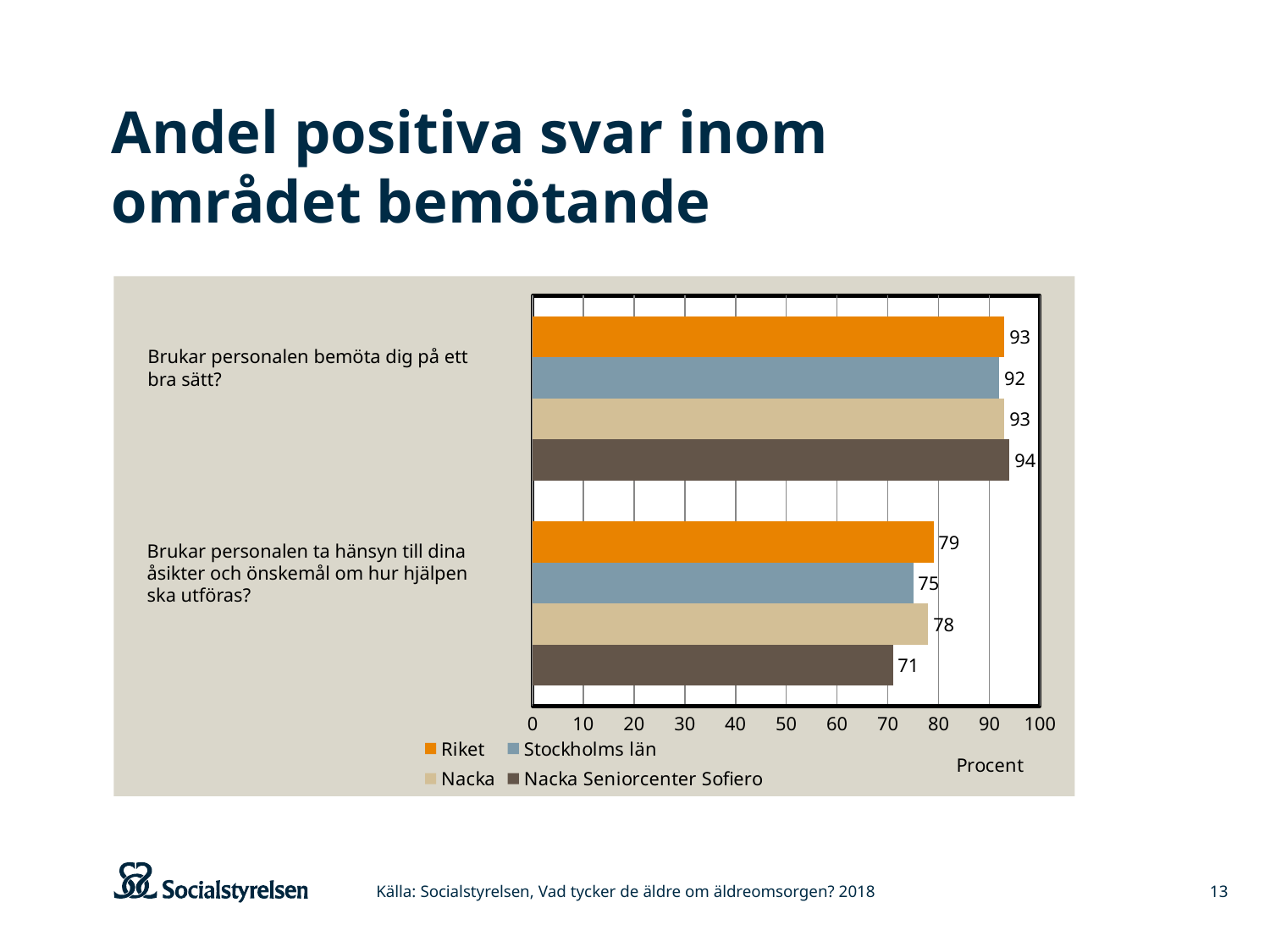
What is the value for Riket for "Brukar personalen bemöta dig på ett bra sätt?"? 93 What is the value for Nacka Seniorcenter Sofiero for "Brukar personalen ta hänsyn till dina åsikter och önskemål om hur hjälpen ska utföras?"? 71 What is the value for Stockholms län for "Brukar personalen ta hänsyn till dina åsikter och önskemål om hur hjälpen ska utföras?"? 75 What kind of chart is shown on the slide? Bar chart Which series has the lowest value for "Brukar personalen ta hänsyn till dina åsikter och önskemål om hur hjälpen ska utföras?"? Nacka Seniorcenter Sofiero How many question categories are shown on the chart? 2 What is the value for Nacka for "Brukar personalen bemöta dig på ett bra sätt?"? 93 What is the difference between the Riket value and the Nacka Seniorcenter Sofiero value for "Brukar personalen ta hänsyn till dina åsikter och önskemål om hur hjälpen ska utföras?"? 8 Which series has the highest value for "Brukar personalen bemöta dig på ett bra sätt?"? Nacka Seniorcenter Sofiero What unit is shown on the horizontal axis of the chart? Procent For "Brukar personalen ta hänsyn till dina åsikter och önskemål om hur hjälpen ska utföras?", which is larger: the Riket value or the Stockholms län value? Riket How many series does the legend list? 4